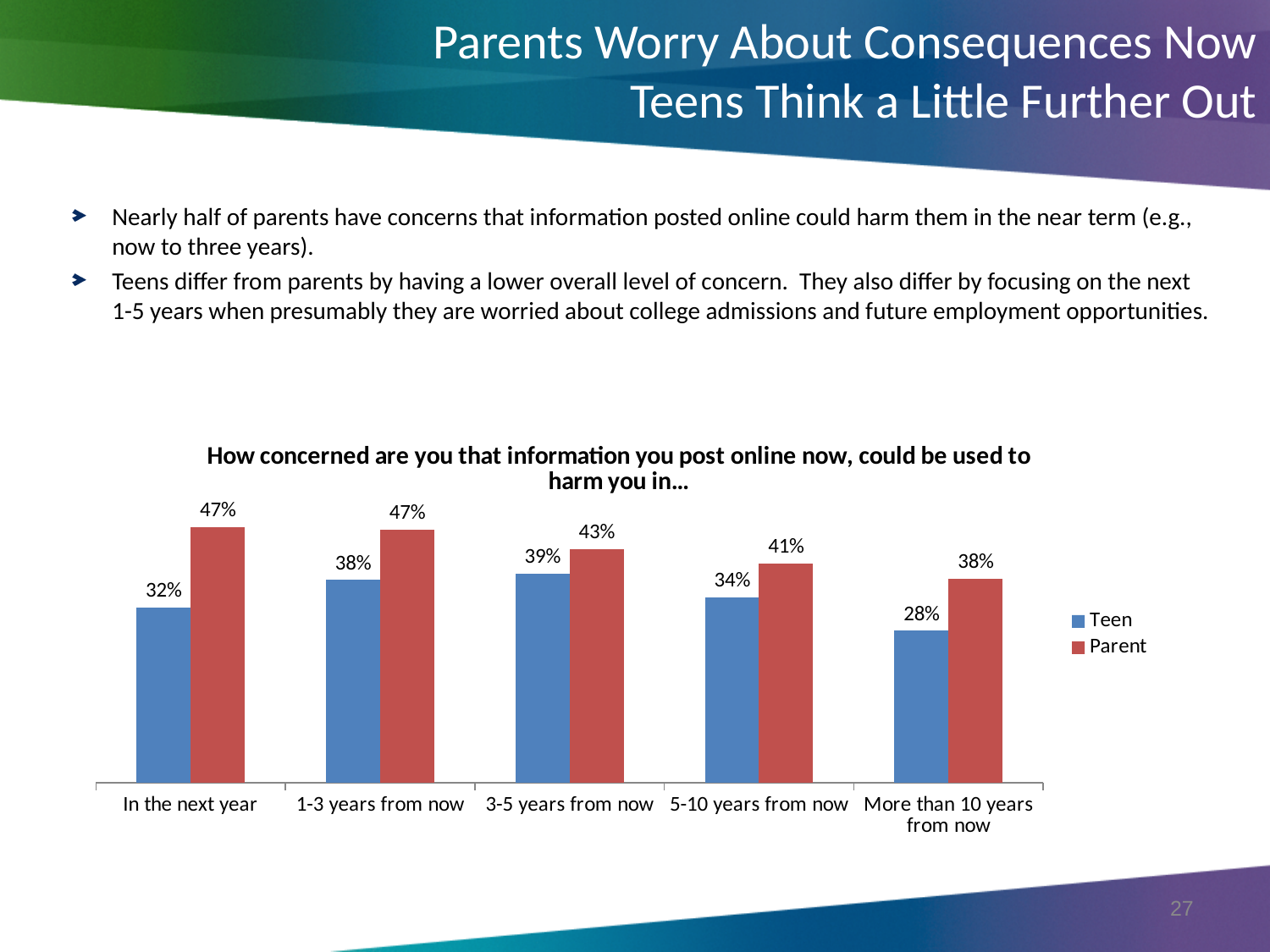
What kind of chart is shown on the slide? Bar chart What is the Teen value for "In the next year"? 32% How many series does the legend list? 2 Which is larger for "3-5 years from now": the Teen value or the Parent value? Parent Which category has the lowest Parent value? More than 10 years from now How many categories are shown on the x axis? 5 What is the Parent value for "5-10 years from now"? 41% Do the Parent values rise or fall from "In the next year" to "More than 10 years from now"? Fall What is the Teen value for "More than 10 years from now"? 28% What is the difference between the Parent and Teen values for "In the next year"? 15% Which category has the highest Teen value? 3-5 years from now What colour represents the Parent series? Red